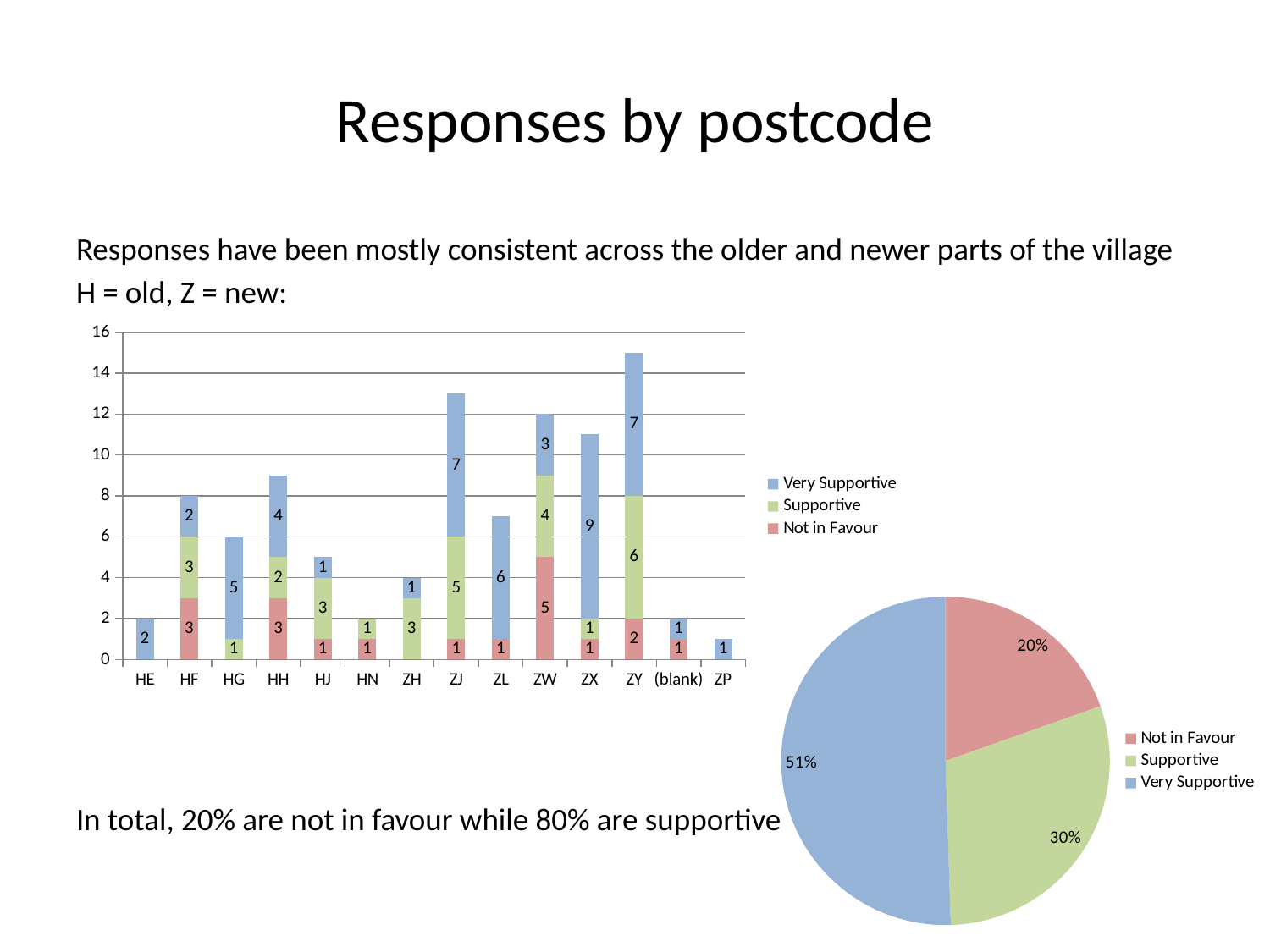
In the stacked bar chart on the left, how many series does the legend list? 3 In the stacked bar chart on the left, which is larger: the Supportive value for ZJ or the Supportive value for HH? ZJ In the stacked bar chart on the left, what is the Supportive value for ZY? 6 In the stacked bar chart on the left, which postcode has the tallest stacked bar? ZY In the stacked bar chart on the left, what is the total of the stacked bar for ZJ? 13 In the stacked bar chart on the left, what is the total of the stacked bar for HF? 8 In the stacked bar chart on the left, what is the Very Supportive value for ZX? 9 In the stacked bar chart on the left, what is the Not in Favour value for ZW? 5 In the stacked bar chart on the left, what is the difference between the Very Supportive values for ZJ and ZW? 4 In the pie chart on the right, what share is Very Supportive? 51% In the stacked bar chart on the left, how many categories are shown on the x axis? 14 In the pie chart on the right, which slice is the smallest? Not in Favour